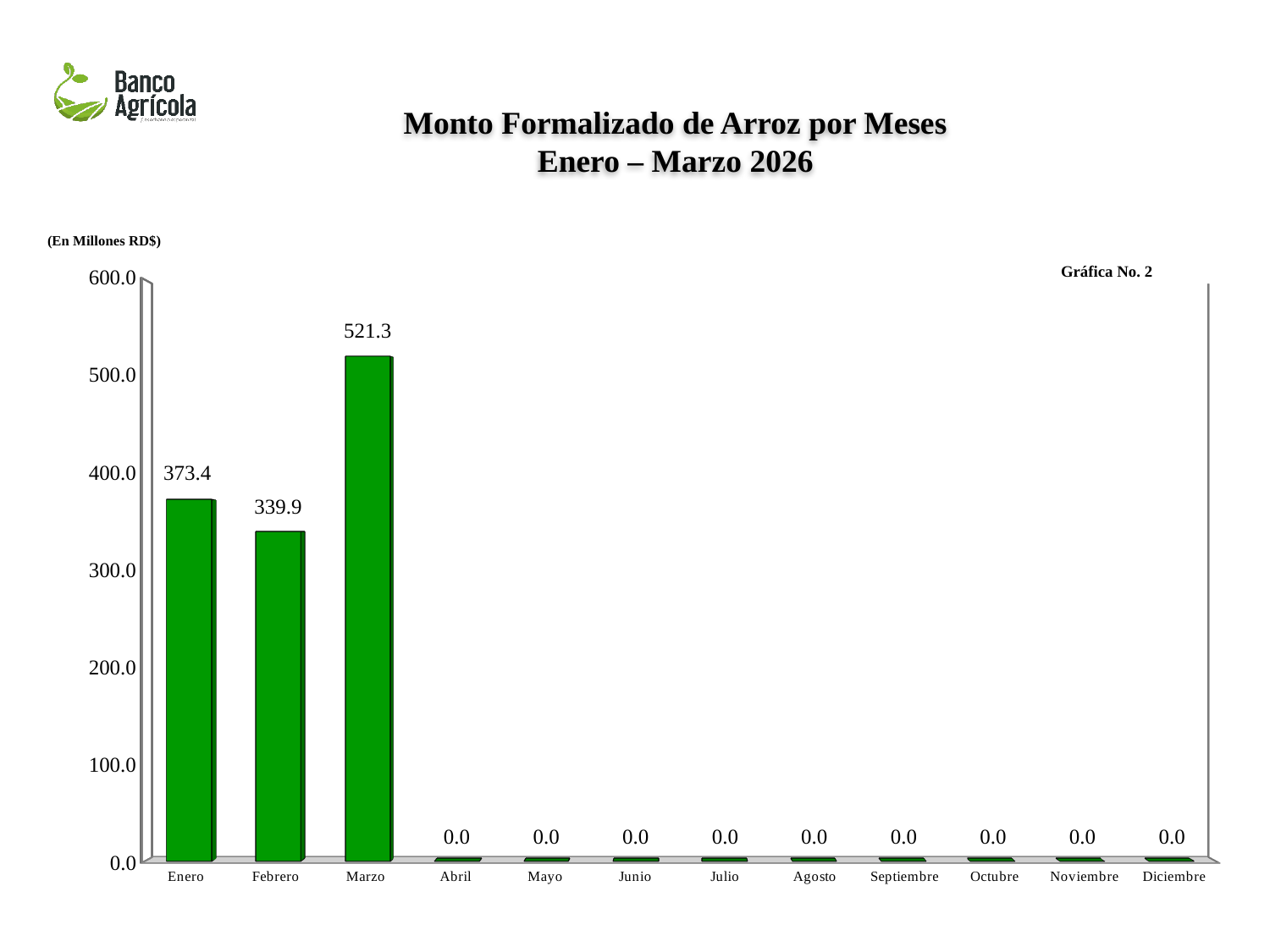
What is the value for Marzo? 521.3 How many months are shown on the x axis? 12 Which is larger, the value for Enero or the value for Febrero? Enero What unit is stated for the values in the chart? En Millones RD$ What kind of chart is shown on the slide? bar chart What is the difference between the values for Marzo and Enero? 147.9 Which month has the highest value? Marzo What is the value for Abril? 0.0 What is the value for Enero? 373.4 What is the difference between the values for Enero and Febrero? 33.5 What is the value for Febrero? 339.9 Is the value for Marzo greater or less than 500.0? greater